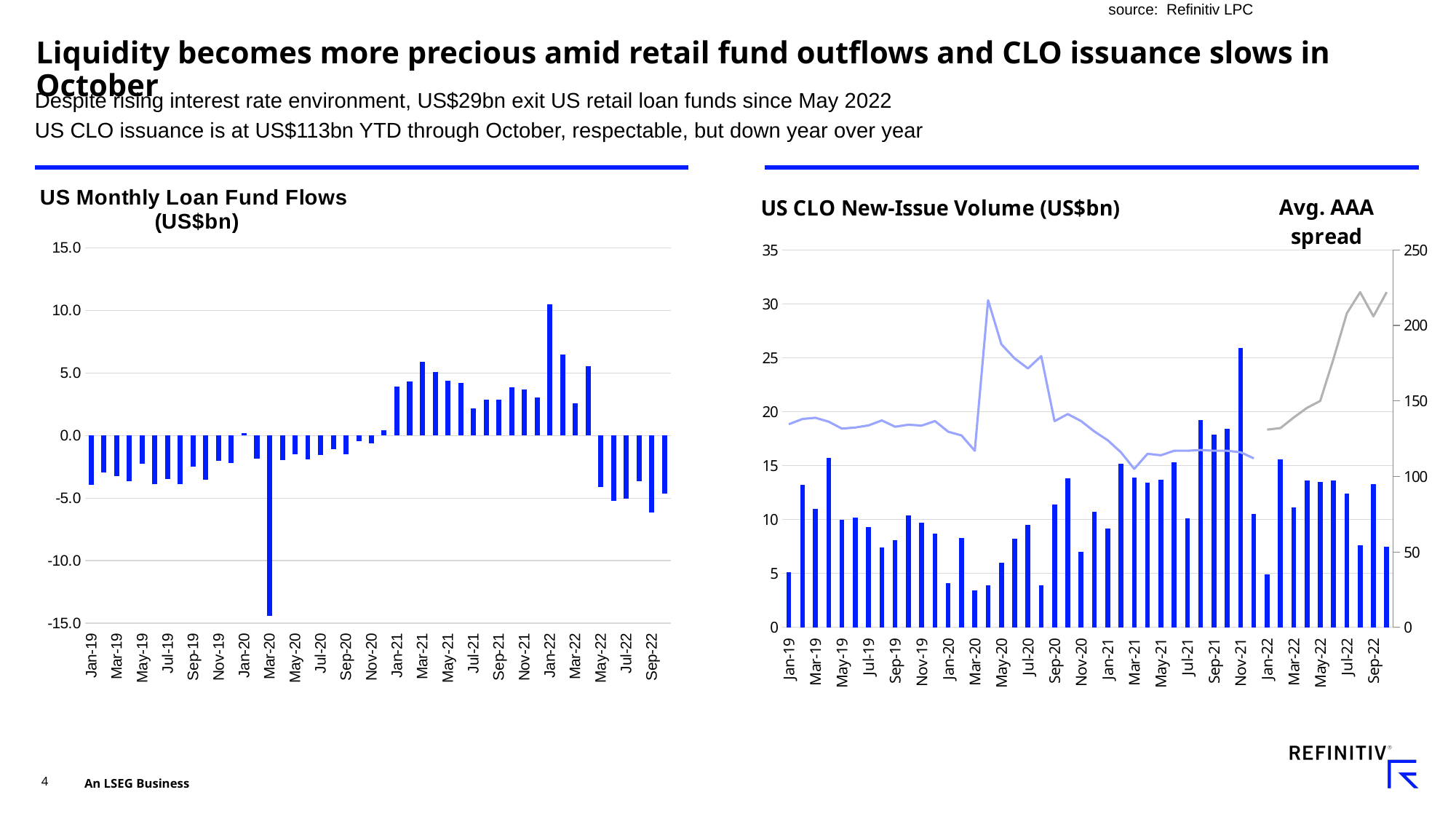
In the US CLO New-Issue Volume chart, what is the maximum value shown on the right-hand axis? 250 In the US Monthly Loan Fund Flows chart, is the value for Mar-21 greater or less than 5.0? greater In the US Monthly Loan Fund Flows chart, which month has the highest value? Jan-22 In the US CLO New-Issue Volume chart, does the Avg. AAA spread line rise or fall across 2022? rise In the US Monthly Loan Fund Flows chart, is the value for Sep-22 greater or less than -5.0? less In the US Monthly Loan Fund Flows chart, which is larger, the value for Jan-22 or the value for Mar-22? Jan-22 In the US Monthly Loan Fund Flows chart, is the value for Mar-20 greater or less than -10.0? less What kind of chart is the US Monthly Loan Fund Flows chart? bar chart In the US CLO New-Issue Volume chart, which month has the tallest bar? Nov-21 In the US Monthly Loan Fund Flows chart, which month has the lowest value? Mar-20